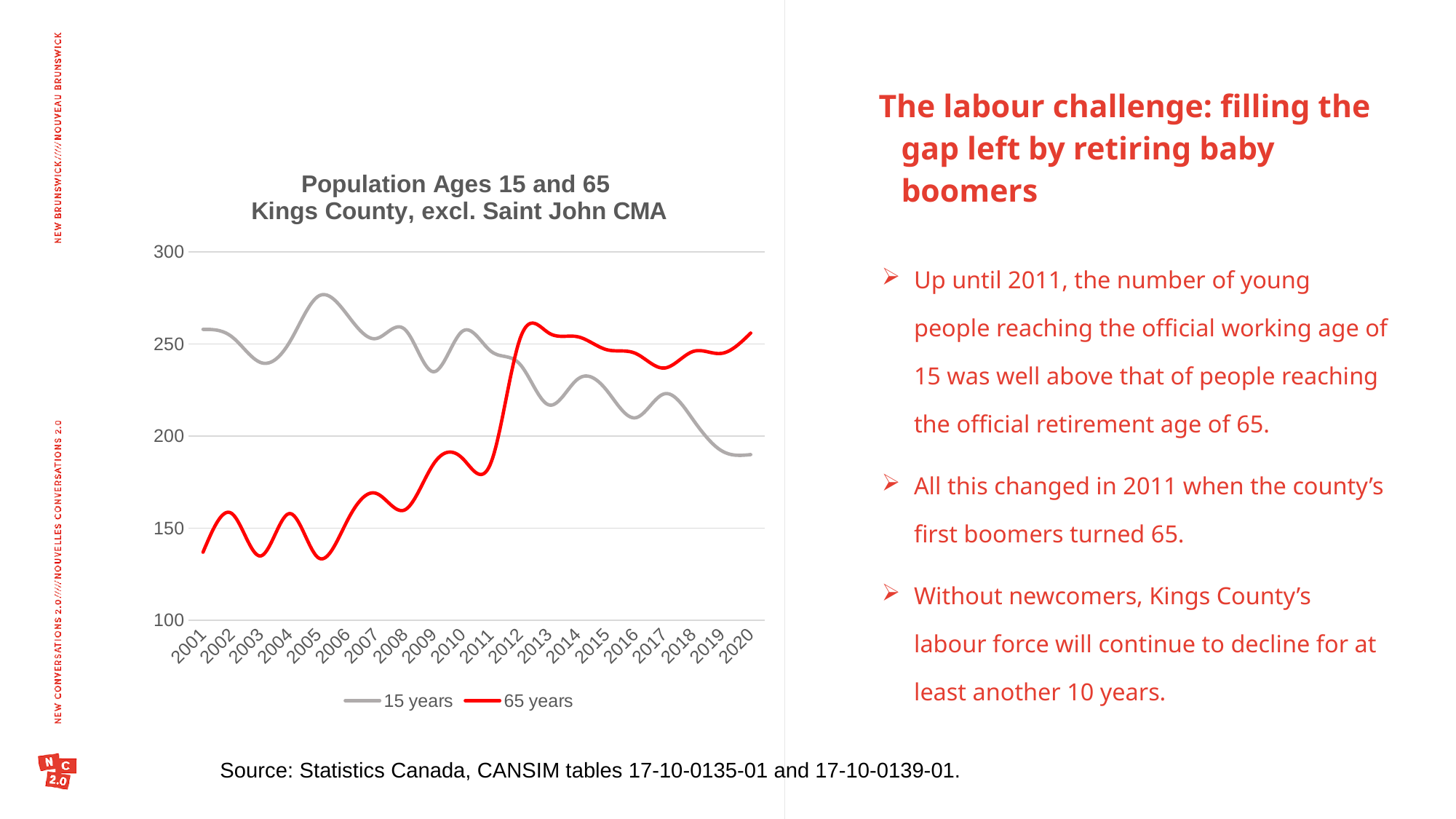
What is the title of the chart? Population Ages 15 and 65 Kings County, excl. Saint John CMA Does the 15 years series rise or fall from 2010 to 2020? fall How many series does the legend list? 2 Is the value for 65 years in 2001 greater or less than 150? less Is the value for 15 years in 2020 greater or less than 200? less Is the value for 65 years in 2020 greater or less than 250? greater In 2020, which series has the larger value, 15 years or 65 years? 65 years What kind of chart is shown on the slide? line chart In 2001, which series has the larger value, 15 years or 65 years? 15 years What are the two series named in the legend? 15 years and 65 years How many years are plotted along the x axis? 20